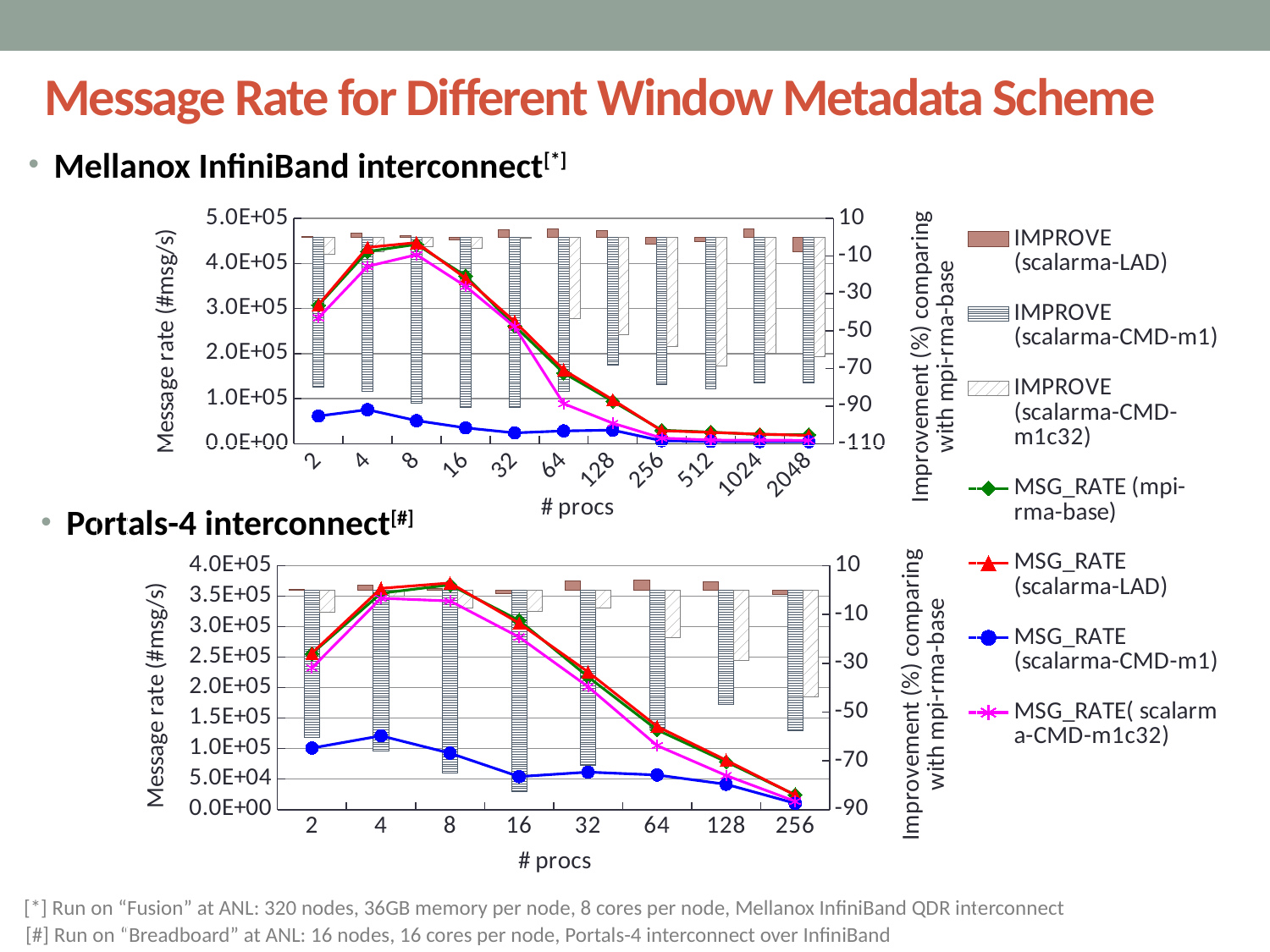
In the Portals-4 interconnect chart, is the MSG_RATE (scalarma-CMD-m1) value at 4 procs greater or less than 1.0E+05? greater In the Portals-4 interconnect chart, at which # procs is MSG_RATE (scalarma-LAD) lowest? 256 In the Portals-4 interconnect chart, is the MSG_RATE (scalarma-LAD) value at 8 procs greater or less than 3.5E+05? greater What is the label of the left vertical axis in the Mellanox InfiniBand interconnect chart? Message rate (#msg/s) In the Mellanox InfiniBand interconnect chart, how many # procs categories are shown on the x axis? 11 In the Portals-4 interconnect chart, does MSG_RATE (scalarma-LAD) rise or fall from 8 procs to 256 procs? fall How many series does the legend list for the charts on this slide? 7 In the Portals-4 interconnect chart, at 2 procs, which is larger: MSG_RATE (mpi-rma-base) or MSG_RATE (scalarma-CMD-m1)? MSG_RATE (mpi-rma-base) In the Portals-4 interconnect chart, how many # procs categories are shown on the x axis? 8 In the Mellanox InfiniBand interconnect chart, at 64 procs, which is larger: MSG_RATE (scalarma-LAD) or MSG_RATE (scalarma-CMD-m1c32)? MSG_RATE (scalarma-LAD) In the Mellanox InfiniBand interconnect chart, is the MSG_RATE (scalarma-CMD-m1) value at 2 procs greater or less than 1.0E+05? less What kind of chart is the Portals-4 interconnect chart? Combined bar and line chart